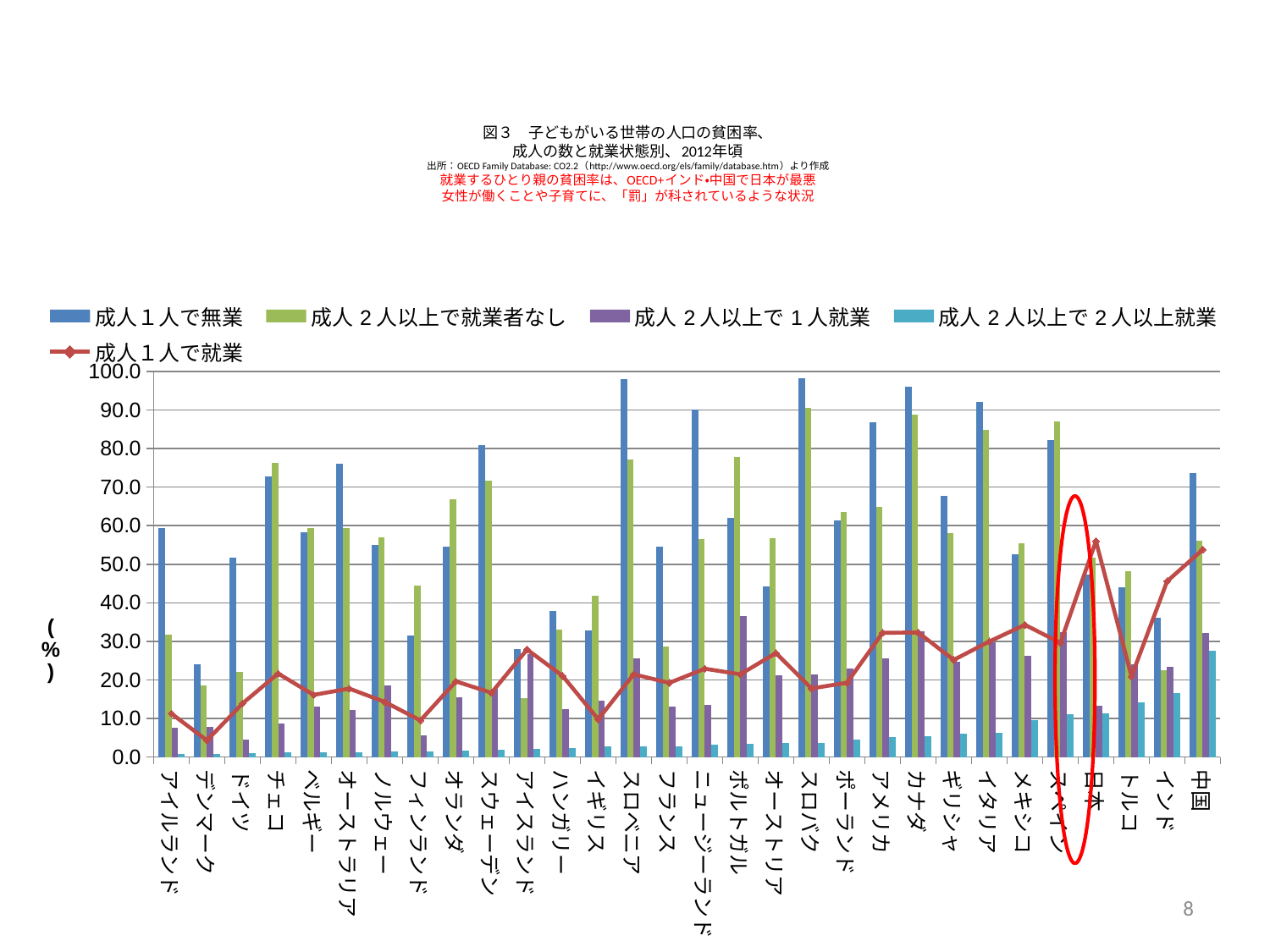
Is the value of 成人１人で就業 for 日本 greater or less than 50? greater How many series does the legend list? 5 Is the value of 成人１人で無業 for スロベニア greater or less than 90? greater Is the value of 成人 2 人以上で就業者なし for チェコ greater or less than 70? greater How many countries are shown on the x axis? 30 Which country has the highest value for 成人１人で就業 (the line series)? 日本 Which country has the lowest value for 成人１人で就業 (the line series)? デンマーク Which is larger, the 成人１人で無業 value for スロベニア or for ハンガリー? スロベニア What kind of chart is this? Bar chart with a line series Does the 成人１人で就業 line rise or fall from スペイン to 日本? rise Which country is circled in red on the chart? 日本